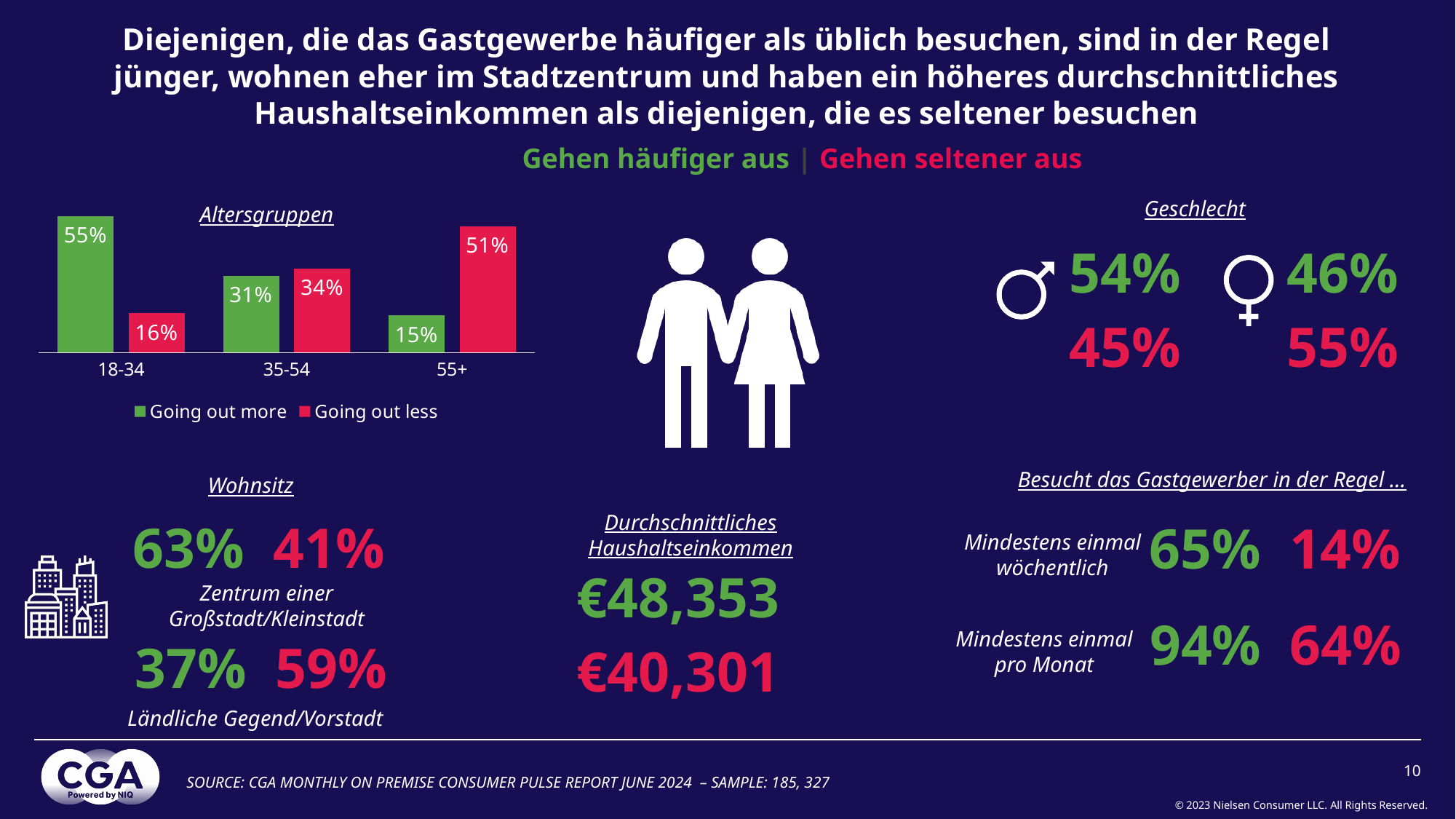
In the Altersgruppen chart, which age group has the highest value for Going out more? 18-34 In the Altersgruppen chart, do the Going out more values rise or fall from the 18-34 group to the 55+ group? Fall In the Altersgruppen chart, what is the value for Going out less in the 35-54 age group? 34% How many series does the legend of the Altersgruppen chart list? 2 In the Altersgruppen chart, which colour represents the Going out less series? Red How many age groups are shown in the Altersgruppen chart? 3 In the Altersgruppen chart, what is the value for Going out more in the 18-34 age group? 55% In the Altersgruppen chart, which is larger for the 55+ age group: Going out more or Going out less? Going out less In the Altersgruppen chart, which age group has the lowest value for Going out less? 18-34 In the Altersgruppen chart, what is the value for Going out less in the 55+ age group? 51% What kind of chart is the Altersgruppen chart? Bar chart In the Altersgruppen chart, what is the difference between Going out more and Going out less for the 18-34 age group? 39%